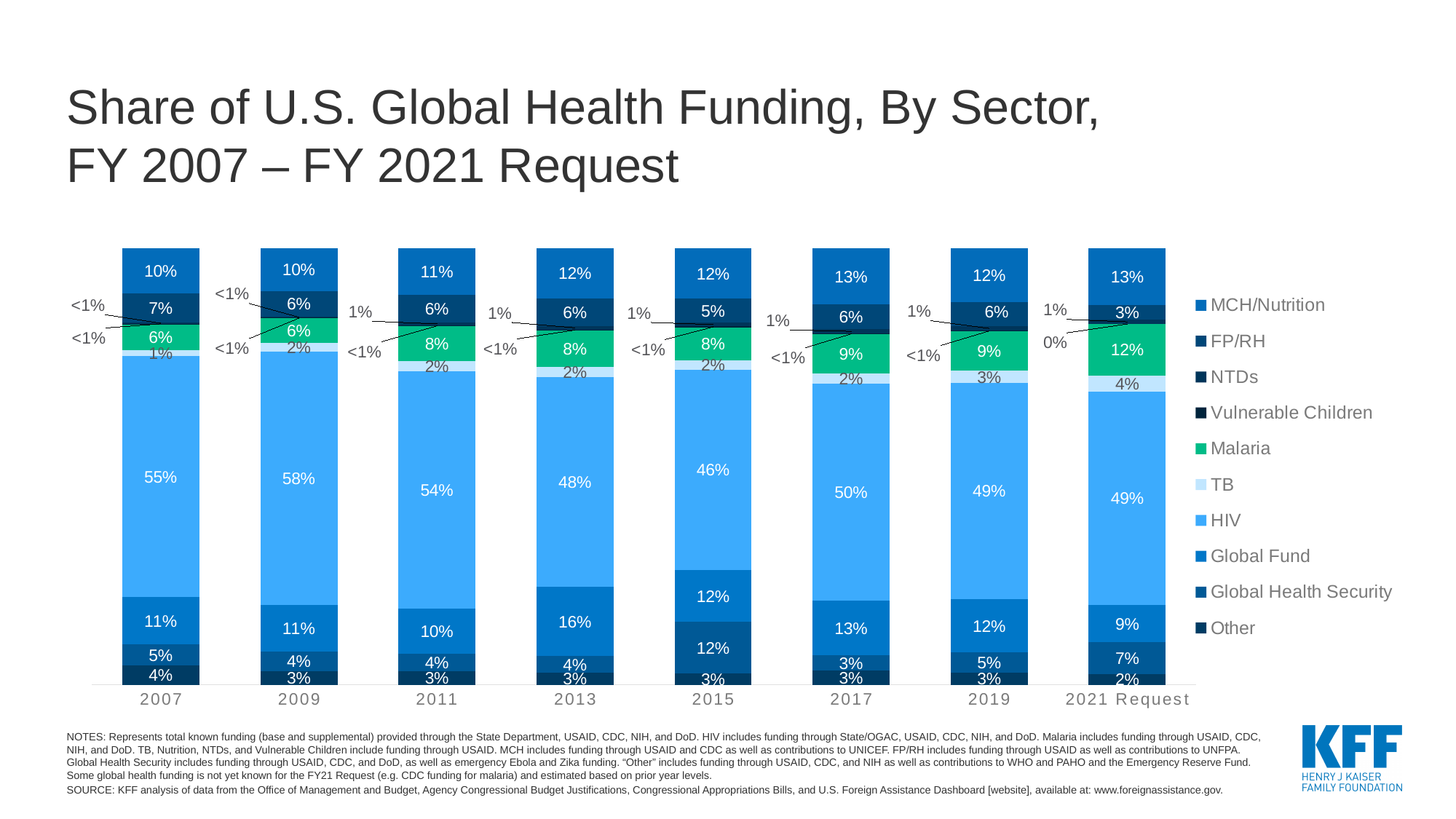
What share of U.S. global health funding went to HIV in FY 2009? 58% What is the Malaria share in the FY 2021 Request? 12% What is the Vulnerable Children share in the FY 2021 Request? 0% What share does Global Health Security have in FY 2015? 12% By how many percentage points did the HIV share fall from FY 2007 to the FY 2021 Request? 6 percentage points What is the Global Fund share in FY 2013? 16% In which year is the Global Fund share the lowest? 2021 Request How many sectors does the legend list? 10 What kind of chart is shown on the slide? Stacked bar chart In which year is the HIV share the highest? 2009 How many years (bars) are shown on the x axis? 8 Which is larger, the Global Fund share in 2013 or in 2015? 2013